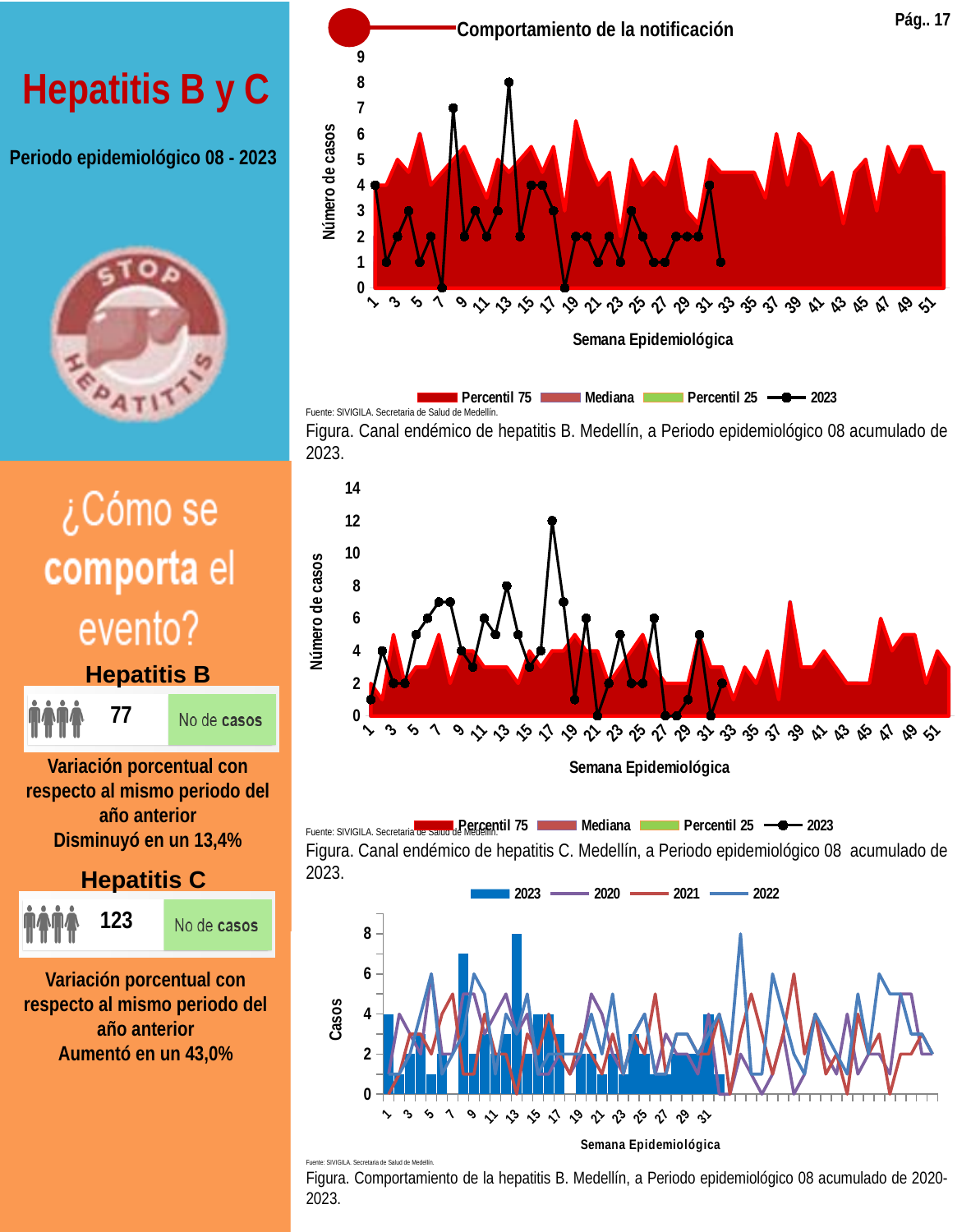
In the top chart (Canal endémico de hepatitis B), which is larger: the 2023 value at week 13 or at week 1? Week 13 In the top chart (Canal endémico de hepatitis B), is the 2023 value at week 13 greater or less than 5? greater In the middle chart (Canal endémico de hepatitis C), in which epidemiological week does the 2023 line reach its highest value? Week 17 In the middle chart (Canal endémico de hepatitis C), what is the value of the 2023 line at week 17? 12 What is the y-axis title of the top chart (Canal endémico de hepatitis B)? Número de casos How many series does the legend of the top chart (Canal endémico de hepatitis B) list? 4 In the middle chart (Canal endémico de hepatitis C), is the 2023 value at week 17 greater or less than 10? greater In the middle chart (Canal endémico de hepatitis C), which is larger: the 2023 value at week 17 or at week 13? Week 17 In the bottom chart (Comportamiento de la hepatitis B 2020-2023), which series is drawn as bars rather than lines? 2023 In the bottom chart (Comportamiento de la hepatitis B 2020-2023), in which week is the tallest 2023 bar? Week 13 In the top chart (Canal endémico de hepatitis B), in which epidemiological week does the 2023 line reach its highest value? Week 13 In the top chart (Canal endémico de hepatitis B), what is the value of the 2023 line at week 13? 8